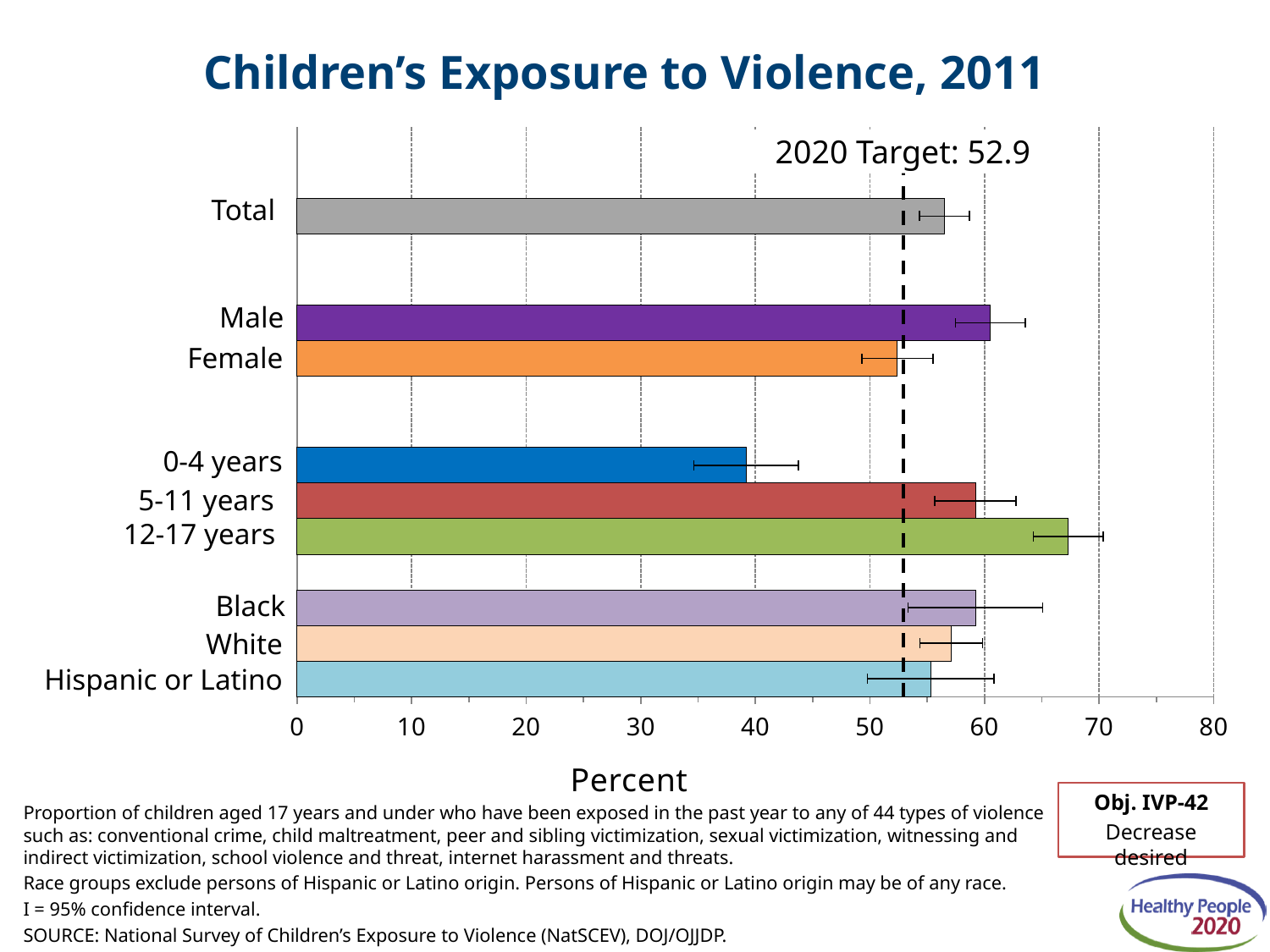
Is the value for Hispanic or Latino greater or less than 60? less Which category has the lowest value in the chart? 0-4 years Which category has the highest value in the chart? 12-17 years What is the 2020 Target value shown on the chart? 52.9 How many categories (bars) are plotted in the chart? 9 Is the value for 12-17 years greater or less than 60? greater Is the value for 0-4 years greater or less than 50? less Which is larger, the value for Male or the value for Female? Male What kind of chart is shown on the slide? bar chart Which is larger, the value for 0-4 years or the value for 5-11 years? 5-11 years What is the label of the x axis? Percent